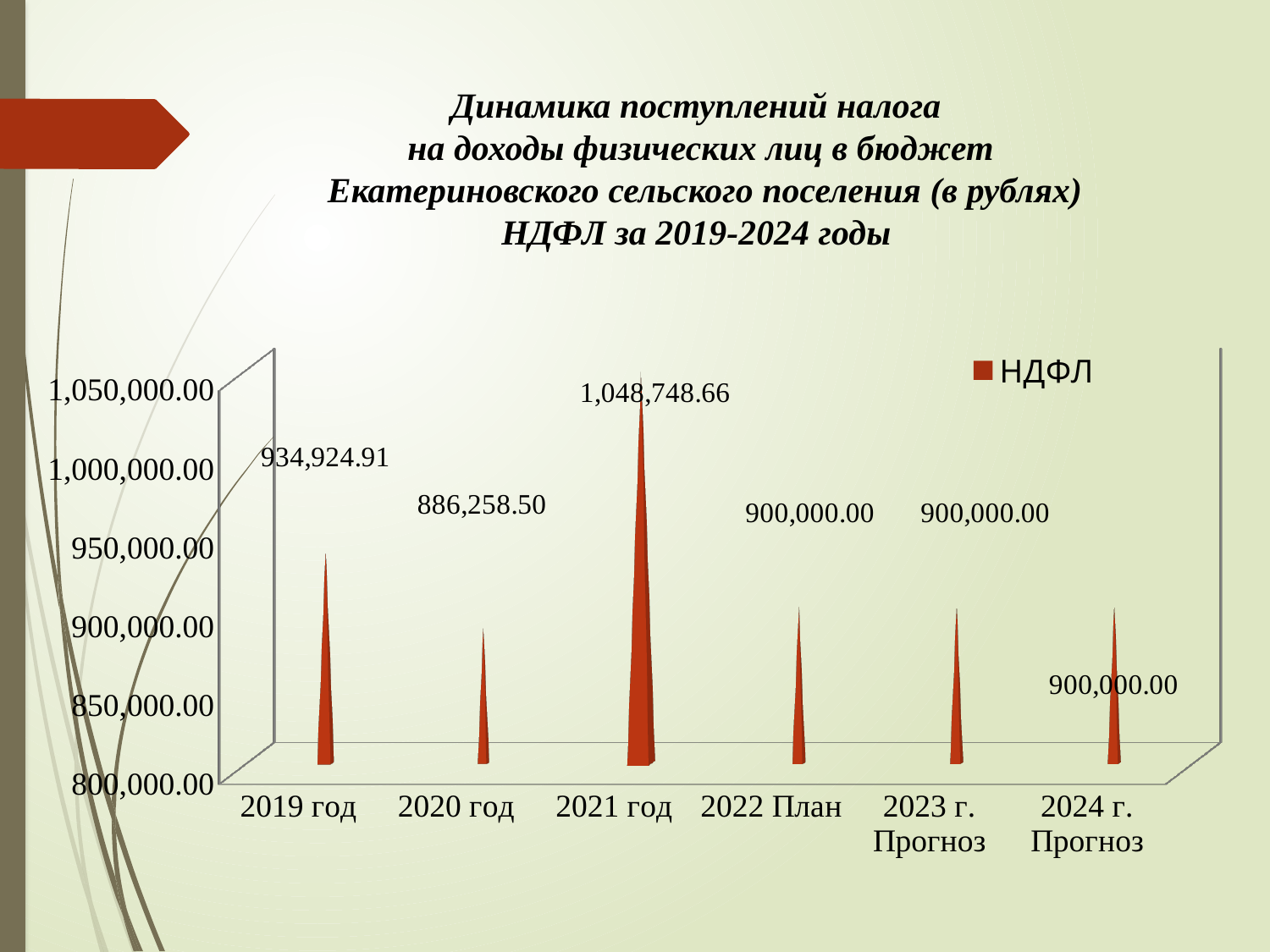
What is the value for 2019 год? 934,924.91 What is the value for 2022 План? 900,000.00 Is the value for 2020 год greater or less than 900,000.00? less What is the value for 2020 год? 886,258.50 What kind of chart is shown on the slide? bar chart Which is larger, the value for 2019 год or the value for 2022 План? 2019 год How many categories are shown on the x axis? 6 Which category has the highest value? 2021 год How many series does the legend list? 1 What is the value for 2021 год? 1,048,748.66 Which category has the lowest value? 2020 год What is the difference between the values for 2021 год and 2020 год? 162,490.16